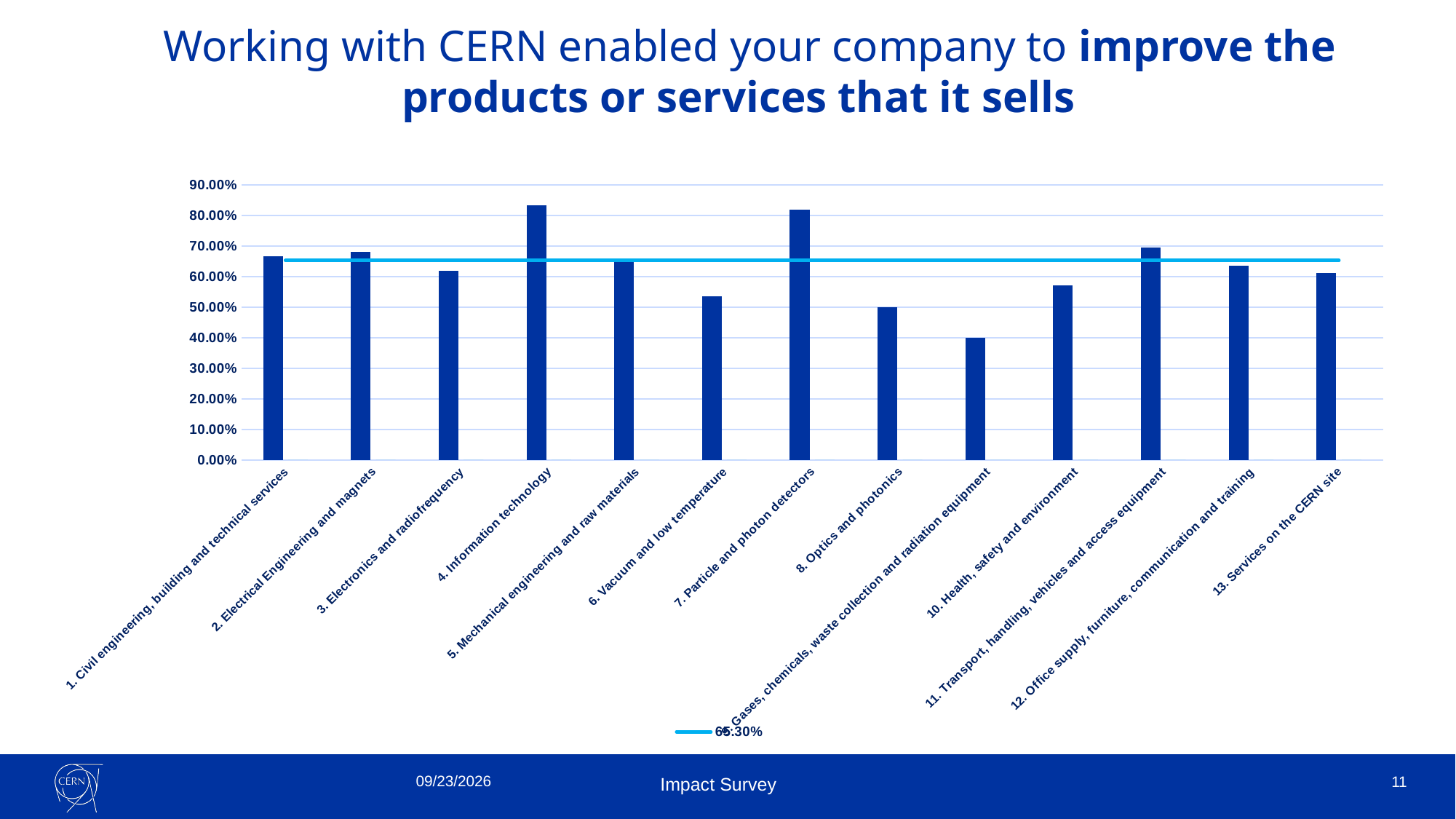
Is the value for 6. Vacuum and low temperature greater or less than 60%? less Which has a higher value: 4. Information technology or 8. Optics and photonics? 4. Information technology Which has a higher value: 2. Electrical Engineering and magnets or 3. Electronics and radiofrequency? 2. Electrical Engineering and magnets What kind of chart is shown on the slide? bar chart What is the highest value shown on the y axis of the chart? 90.00% Which category has the lowest value in the chart? 9. Gases, chemicals, waste collection and radiation equipment How many categories are shown on the x axis of the chart? 13 Is the value for 7. Particle and photon detectors greater or less than 80%? greater Is the value for 9. Gases, chemicals, waste collection and radiation equipment greater or less than 50%? less What value does the horizontal reference line in the legend represent? 65.30%